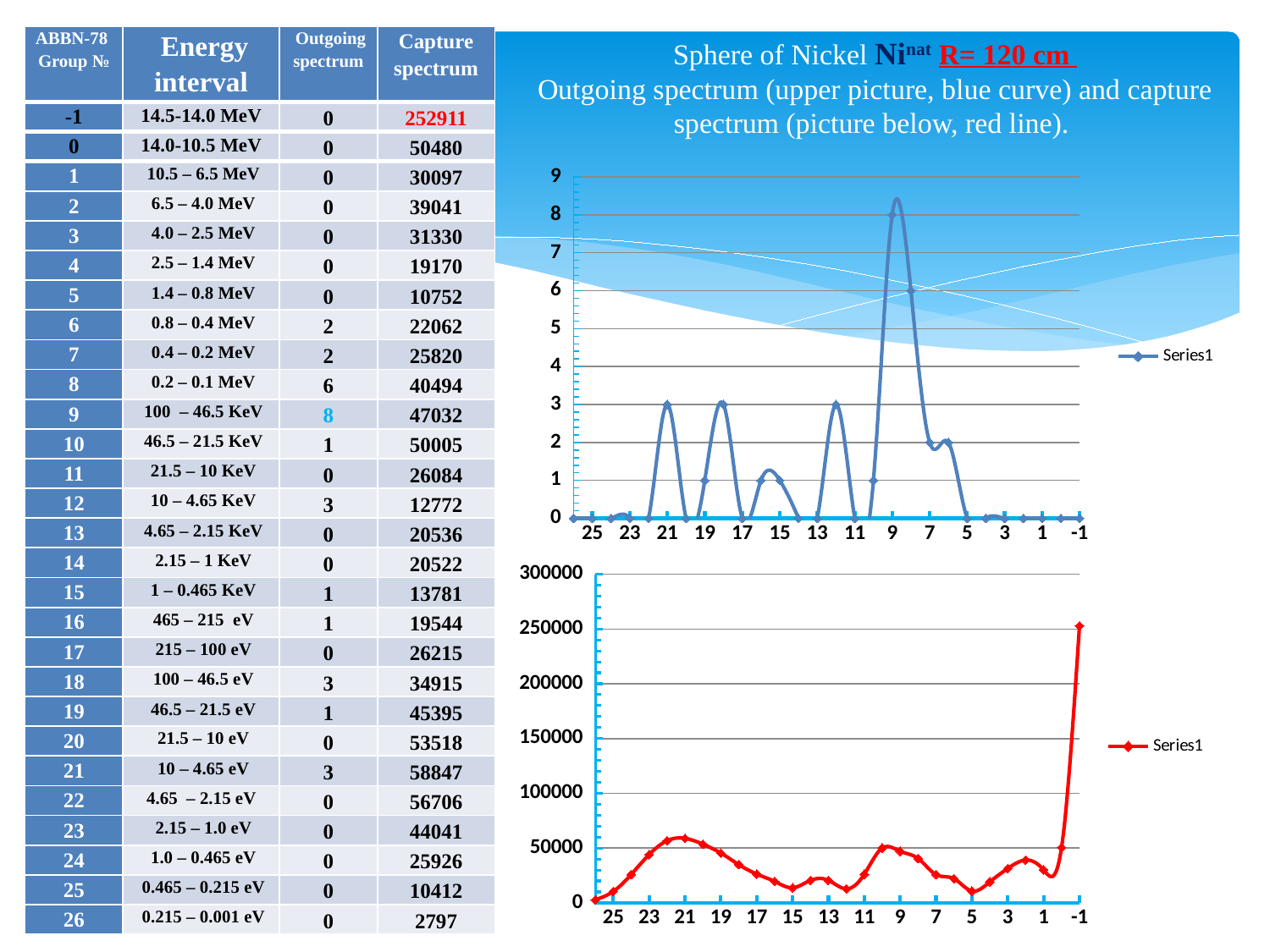
In the lower chart (red line), at which group number is the value highest? -1 In the lower chart (red line), is the value at group 21 greater or less than 100000? less In the upper chart (blue curve), what is the value at group 8? 6 In the lower chart (red line), which is larger, the value at group 21 or the value at group 9? group 21 In the upper chart (blue curve), at which group number is the value highest? 9 In the upper chart (blue curve), what is the value at group 9? 8 In the lower chart (red line), at which group number is the value lowest? 26 How many series does the legend of the upper chart list? 1 In the lower chart (red line), is the value at group -1 greater or less than 200000? greater What kind of chart is the lower chart (red line)? line chart What kind of chart is the upper chart (blue curve)? line chart What is the legend entry shown for the lower chart (red line)? Series1